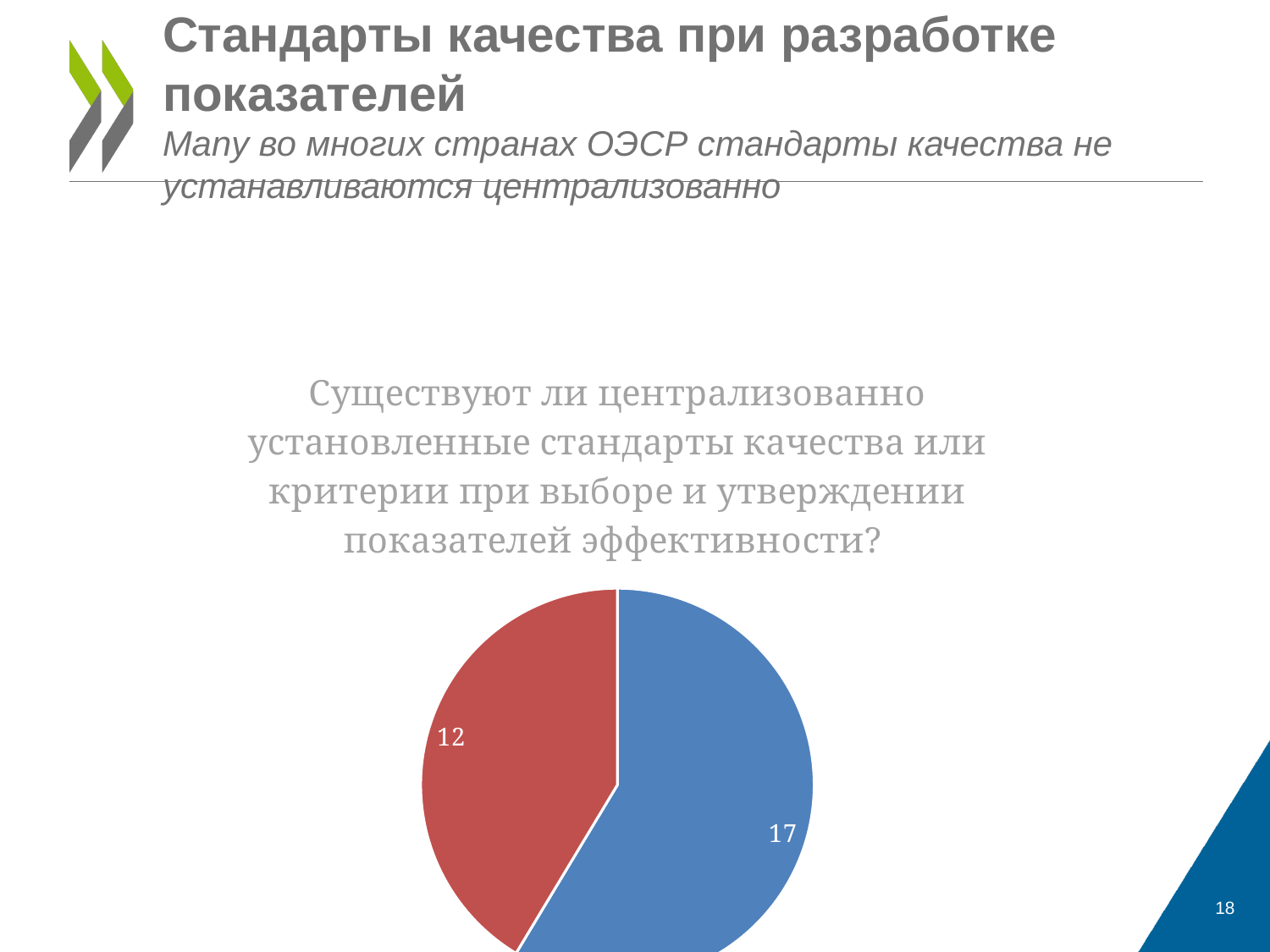
What value is shown on the blue slice of the pie chart? 17 What kind of chart is shown on the slide? pie chart What is the total of the two values shown in the pie chart? 29 Which slice of the pie chart is larger, the blue one or the red one? the blue one Which colour slice has the lowest value in the pie chart? red What value is shown on the red slice of the pie chart? 12 What is the difference between the values of the blue slice and the red slice? 5 What question is written as the title above the pie chart? Существуют ли централизованно установленные стандарты качества или критерии при выборе и утверждении показателей эффективности? What two colours are used for the slices of the pie chart? blue and red How many slices does the pie chart have? 2 Which colour slice has the highest value in the pie chart? blue Is the value of the blue slice greater or less than 15? greater